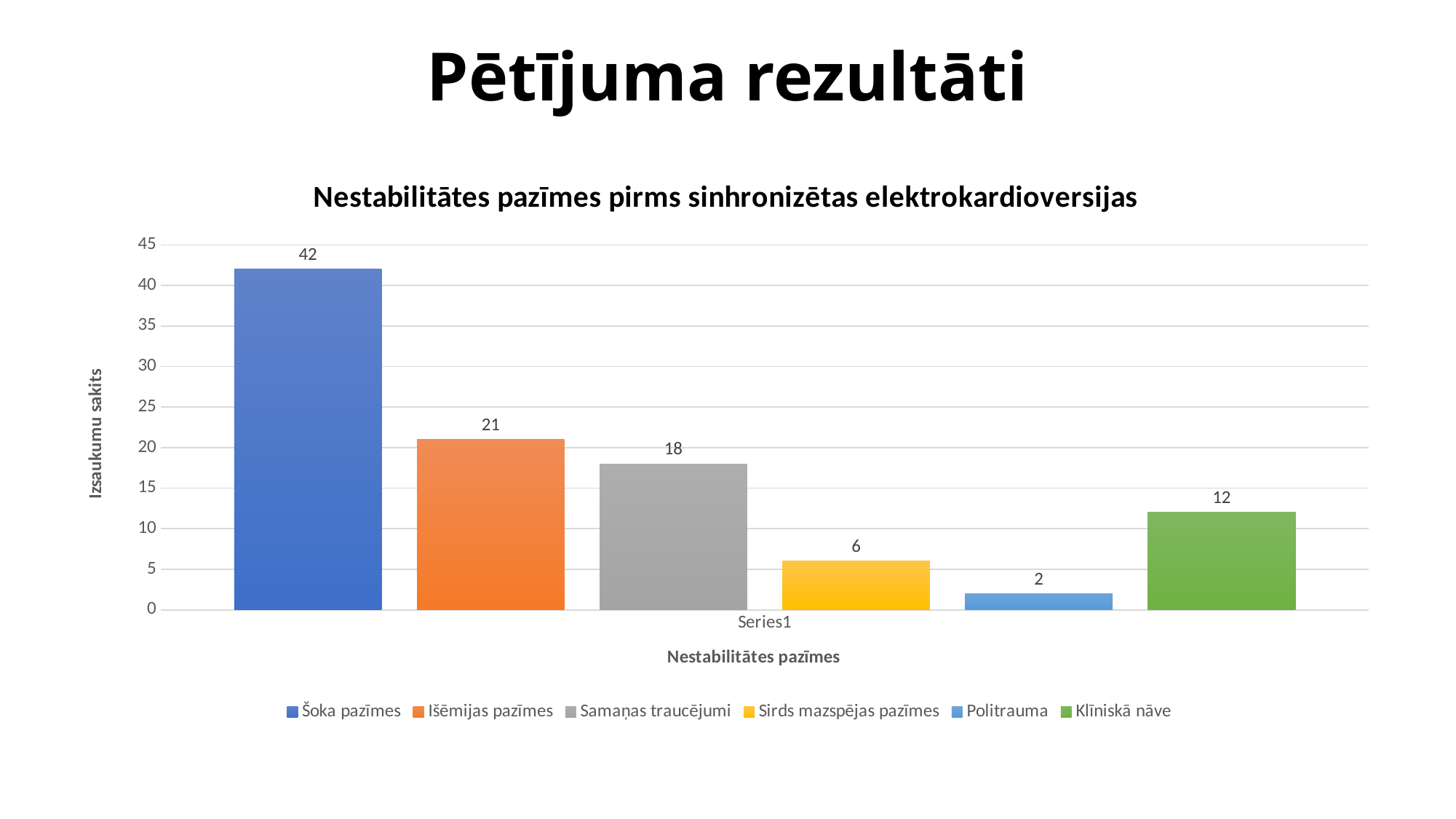
What kind of chart is shown on the slide? Bar chart How many categories are shown in the chart? 6 Which category has the highest value? Šoka pazīmes How many entries does the legend list? 6 What is the value for Klīniskā nāve? 12 Which category has the lowest value? Politrauma What is the value for Išēmijas pazīmes? 21 What is the value for Šoka pazīmes? 42 Which is larger, the value for Klīniskā nāve or the value for Sirds mazspējas pazīmes? Klīniskā nāve What is the difference between the values for Šoka pazīmes and Išēmijas pazīmes? 21 What is the difference between the values for Samaņas traucējumi and Sirds mazspējas pazīmes? 12 What is the title of the chart? Nestabilitātes pazīmes pirms sinhronizētas elektrokardioversijas